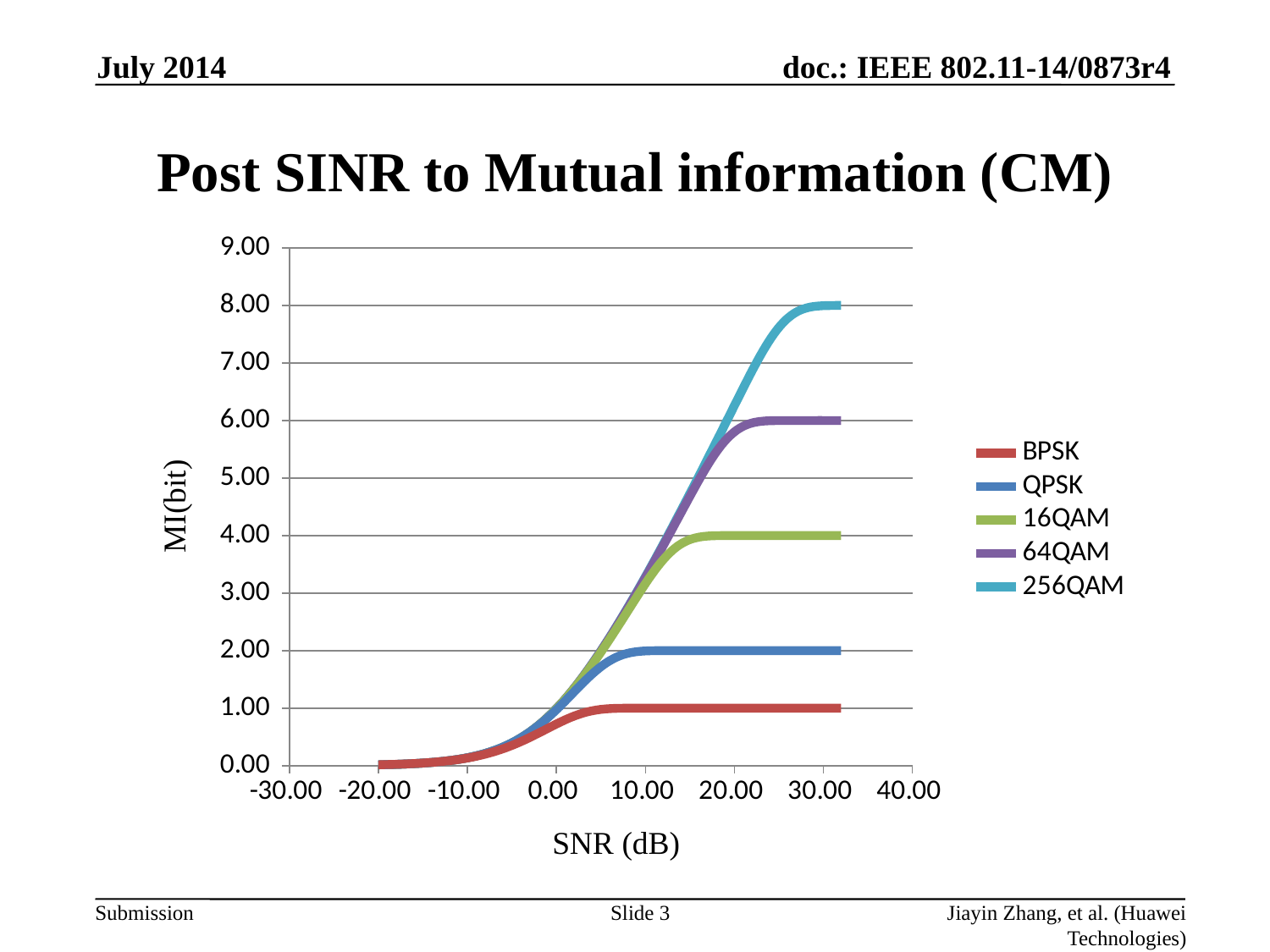
How many series does the legend list? 5 At what MI value does the 256QAM curve level off? 8.00 At what MI value does the 16QAM curve level off? 4.00 Is the MI value for 64QAM at an SNR of 10.00 dB greater or less than 2.00? greater Which series reaches the highest MI value on the chart? 256QAM At an SNR of 30.00 dB, which series has the larger MI value, QPSK or 64QAM? 64QAM What is the label of the x axis? SNR (dB) Which series levels off at the lowest MI value? BPSK At what MI value does the BPSK curve level off? 1.00 What kind of chart is shown on the slide? line chart Do the MI values rise or fall as SNR increases along the x axis? rise Is the MI value for BPSK at an SNR of 20.00 dB greater or less than 2.00? less